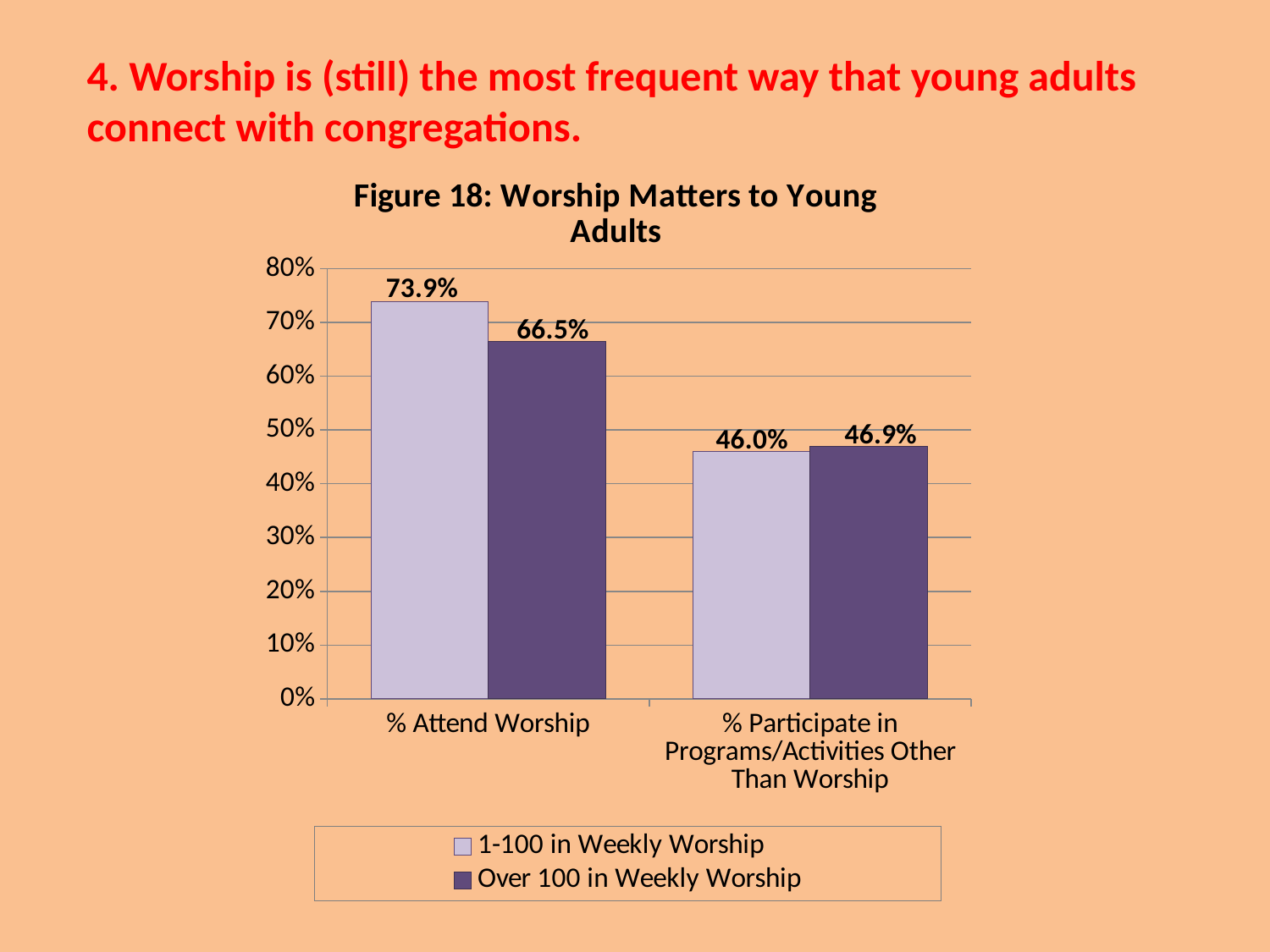
Which bar has the lowest value in the chart? 1-100 in Weekly Worship, % Participate in Programs/Activities Other Than Worship Which bar has the highest value in the chart? 1-100 in Weekly Worship, % Attend Worship What type of chart is shown on the slide? Bar chart What is the value for 'Over 100 in Weekly Worship' in the '% Participate in Programs/Activities Other Than Worship' category? 46.9% How many categories are shown on the x axis? 2 What is the value for '1-100 in Weekly Worship' in the '% Attend Worship' category? 73.9% What is the value for '1-100 in Weekly Worship' in the '% Participate in Programs/Activities Other Than Worship' category? 46.0% How many series does the legend list? 2 Is the value for 'Over 100 in Weekly Worship' in '% Attend Worship' greater or less than 60%? greater What is the difference between the '1-100 in Weekly Worship' and 'Over 100 in Weekly Worship' values for '% Attend Worship'? 7.4% What is the value for 'Over 100 in Weekly Worship' in the '% Attend Worship' category? 66.5% For '% Attend Worship', which series has the larger value: '1-100 in Weekly Worship' or 'Over 100 in Weekly Worship'? 1-100 in Weekly Worship